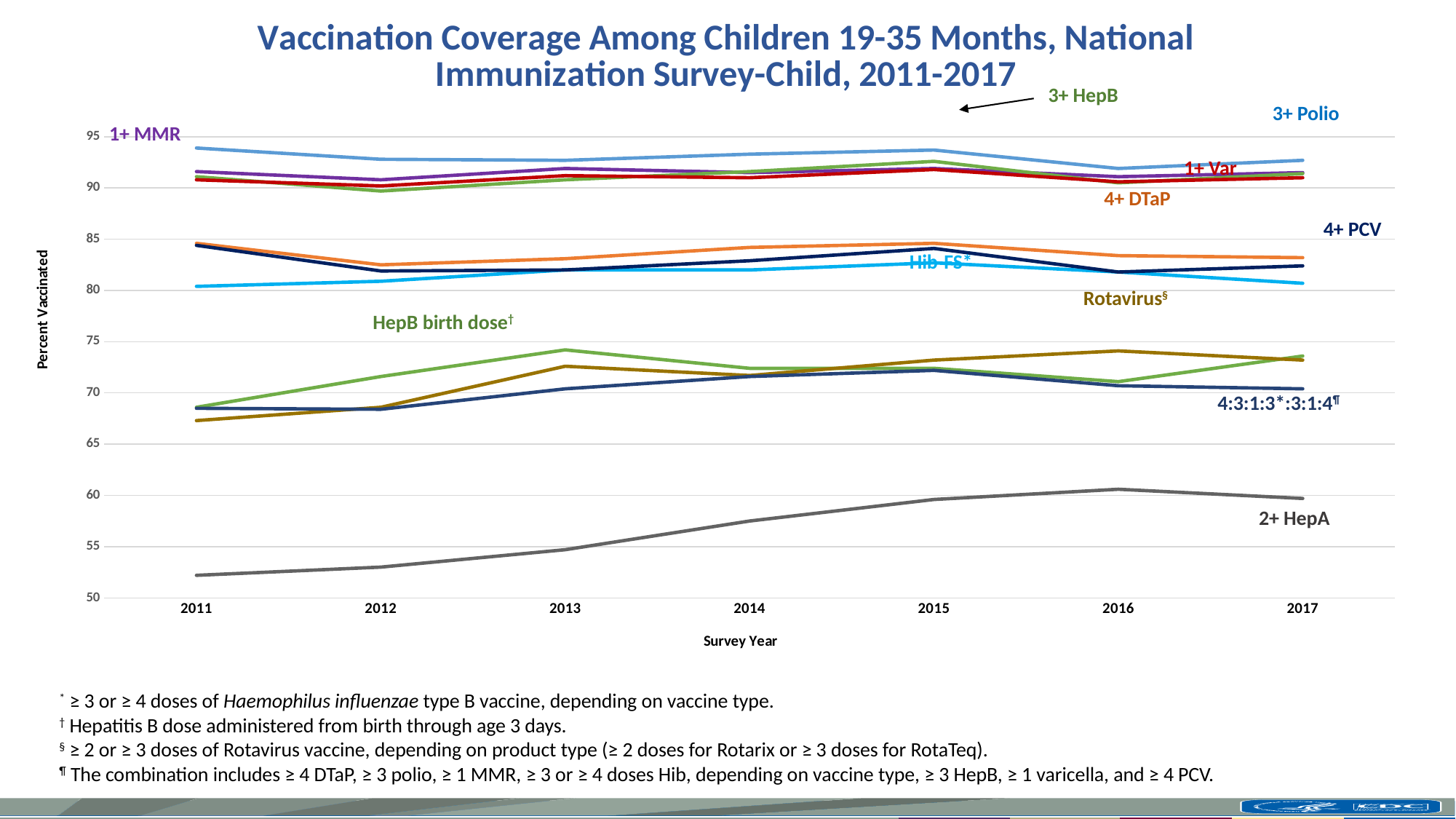
Is the value for Hib FS in 2011 greater or less than 85? less Is the value for 2+ HepA in 2017 greater or less than 55? greater How many survey years are plotted along the x axis? 7 Which is larger in 2015, the value for 3+ Polio or the value for 2+ HepA? 3+ Polio Does the 2+ HepA line rise or fall from 2011 to 2016? rise What is the label on the y axis of the chart? Percent Vaccinated Which vaccine series has the lowest coverage across the chart? 2+ HepA Which vaccine series has the highest coverage across the chart? 3+ Polio What kind of chart is shown on the slide? Line chart Is the value for Rotavirus in 2011 greater or less than 70? less